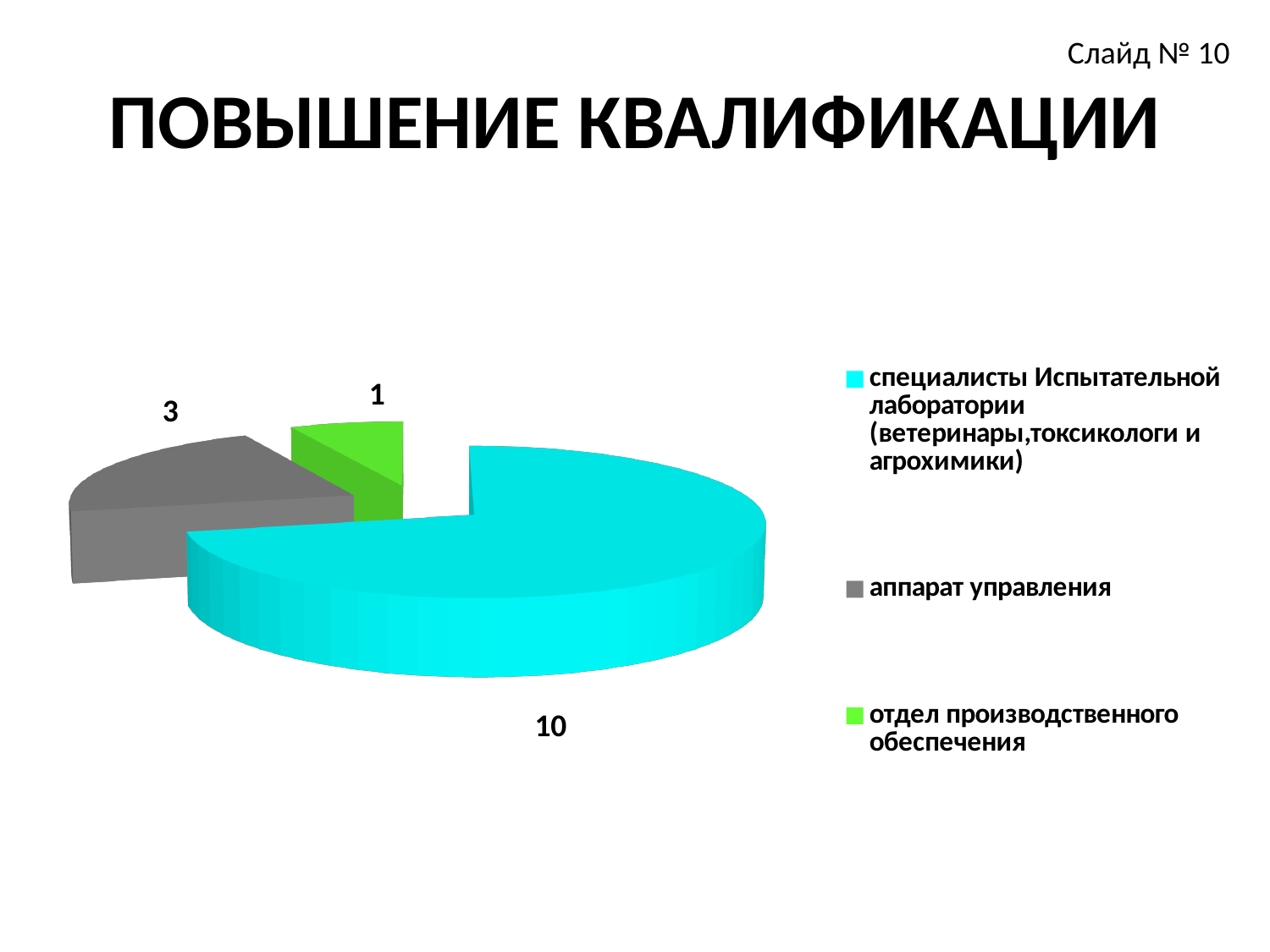
What type of chart is shown on the slide? pie chart What is the difference between the value for специалисты Испытательной лаборатории and the value for аппарат управления? 7 Which is larger: the value for аппарат управления or the value for отдел производственного обеспечения? аппарат управления Which category has the largest slice of the pie? специалисты Испытательной лаборатории (ветеринары, токсикологи и агрохимики) What is the title of the slide containing the chart? ПОВЫШЕНИЕ КВАЛИФИКАЦИИ What is the value for отдел производственного обеспечения? 1 Which category has the smallest slice of the pie? отдел производственного обеспечения What is the value for специалисты Испытательной лаборатории (ветеринары, токсикологи и агрохимики)? 10 How many categories does the pie chart have? 3 What is the total of all the slices in the pie chart? 14 What share of the pie does специалисты Испытательной лаборатории represent? 71.4% What is the value for аппарат управления? 3